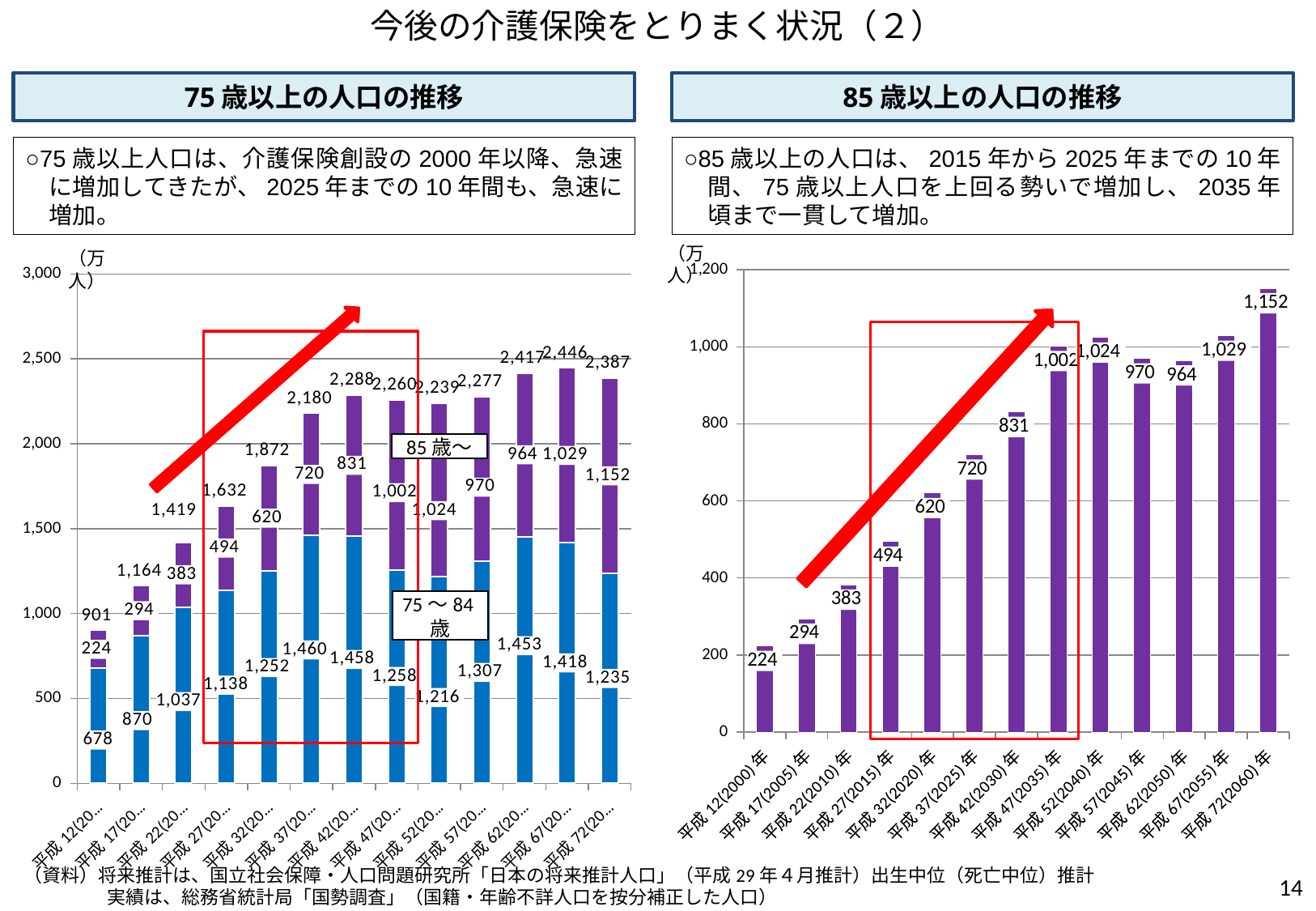
In the right chart (85歳以上の人口の推移), what is the value for 平成47(2035)年? 1,002 In the right chart (85歳以上の人口の推移), how many bars are plotted? 13 In the left chart (75歳以上の人口の推移), what is the total of the stacked bar for 平成27? 1,632 In the left chart (75歳以上の人口の推移), how many series are stacked in each bar? 2 In the right chart (85歳以上の人口の推移), is the value for 平成62(2050)年 greater or less than 1,000? less In the right chart (85歳以上の人口の推移), what is the difference between the values for 平成72(2060)年 and 平成12(2000)年? 928 In the right chart (85歳以上の人口の推移), which year has the highest value? 平成72(2060)年 In the right chart (85歳以上の人口の推移), which year has the lowest value? 平成12(2000)年 What kind of chart is the left chart (75歳以上の人口の推移)? stacked bar chart In the right chart (85歳以上の人口の推移), which is larger, the value for 平成52(2040)年 or 平成57(2045)年? 平成52(2040)年 In the left chart (75歳以上の人口の推移), what is the 75～84歳 value for 平成12? 678 In the right chart (85歳以上の人口の推移), do the values rise or fall from 平成12(2000)年 to 平成47(2035)年? rise